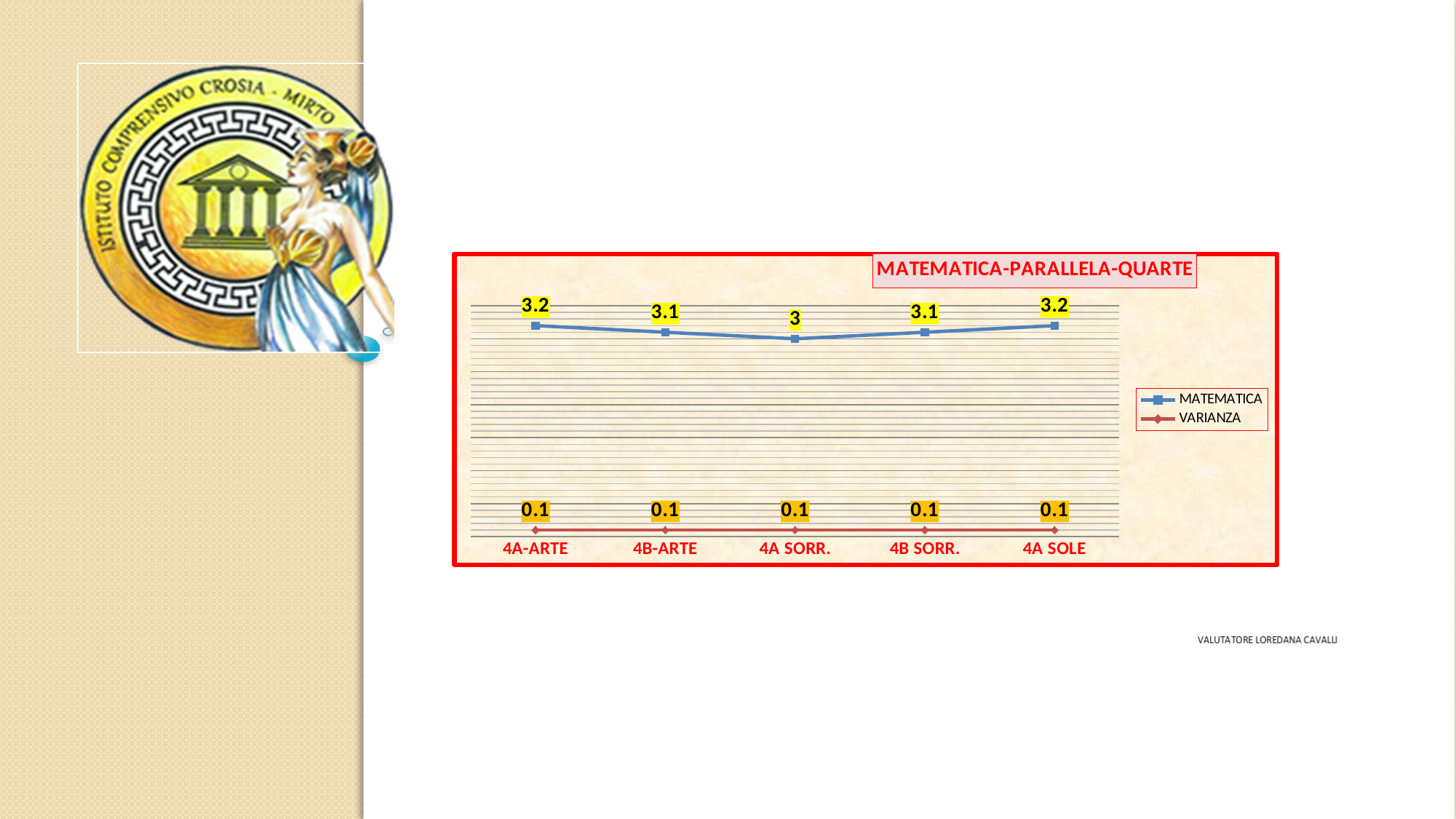
How many series does the legend list? 2 What is the MATEMATICA value for 4A-ARTE? 3.2 What kind of chart is shown? Line chart Does the VARIANZA series rise, fall, or stay flat across the categories? Stays flat Which is larger, the MATEMATICA value for 4B-ARTE or for 4A SORR.? 4B-ARTE What is the difference between the MATEMATICA values for 4A-ARTE and 4A SORR.? 0.2 What is the MATEMATICA value for 4A SORR.? 3 Which series is drawn in blue? MATEMATICA What is the title of the chart? MATEMATICA-PARALLELA-QUARTE Which category has the lowest MATEMATICA value? 4A SORR. What is the VARIANZA value for 4B SORR.? 0.1 How many categories are shown on the x axis? 5